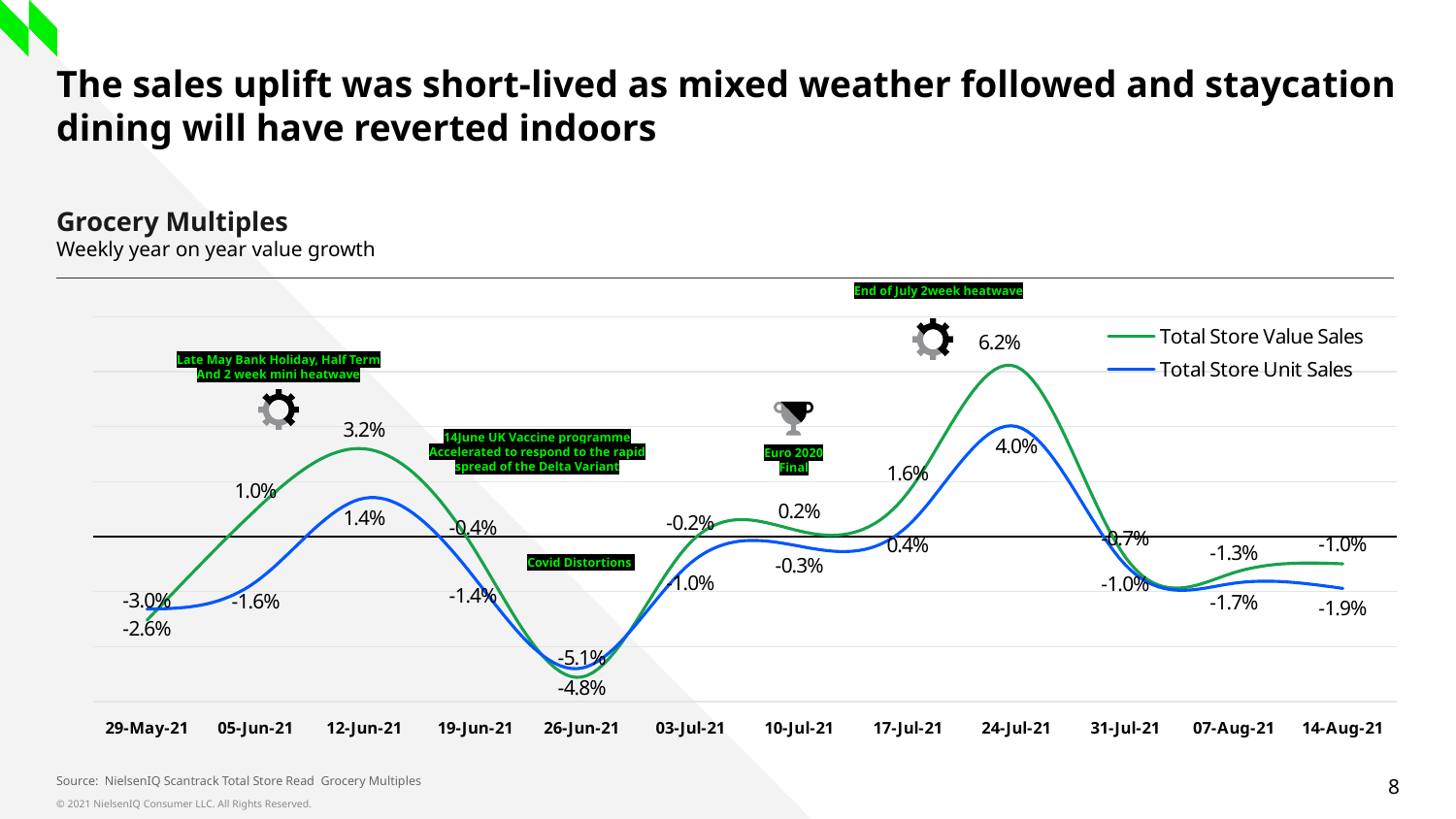
What is the Total Store Unit Sales growth for 24-Jul-21? 4.0% What is the Total Store Value Sales growth for 12-Jun-21? 3.2% On which date is Total Store Value Sales growth highest? 24-Jul-21 How many series does the legend list? 2 Do the Total Store Value Sales values rise or fall from 24-Jul-21 to 31-Jul-21? Fall On which date is Total Store Value Sales growth lowest? 26-Jun-21 What is the difference between Total Store Value Sales and Total Store Unit Sales growth on 24-Jul-21? 2.2 percentage points How many weekly dates are shown on the x axis? 12 What kind of chart is shown on the slide? Line chart What is the Total Store Value Sales growth for 24-Jul-21? 6.2% On 12-Jun-21, which is larger: Total Store Value Sales or Total Store Unit Sales growth? Total Store Value Sales What is the Total Store Unit Sales growth for 26-Jun-21? -4.8%